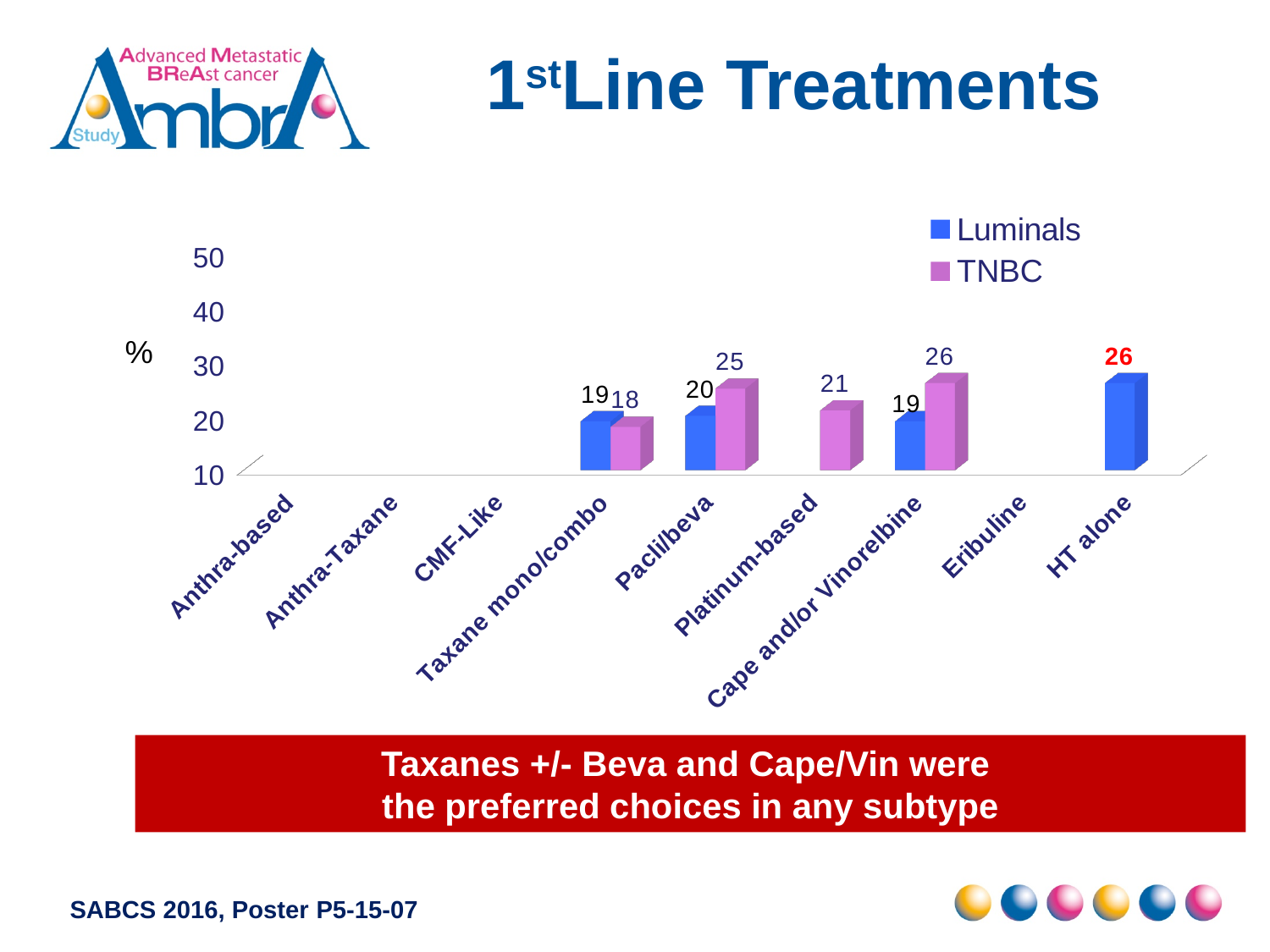
Which category has the highest Luminals value? HT alone What is the Luminals value for Pacli/beva? 20 What is the Luminals value for HT alone? 26 What is the TNBC value for Platinum-based? 21 How many series does the legend list? 2 For Pacli/beva, which series has the larger value, Luminals or TNBC? TNBC What is the TNBC value for Cape and/or Vinorelbine? 26 How many categories are shown on the x axis? 9 Which category has the highest TNBC value? Cape and/or Vinorelbine What is the difference between the TNBC and Luminals values for Cape and/or Vinorelbine? 7 What is the TNBC value for Taxane mono/combo? 18 What kind of chart is shown on the slide? Bar chart